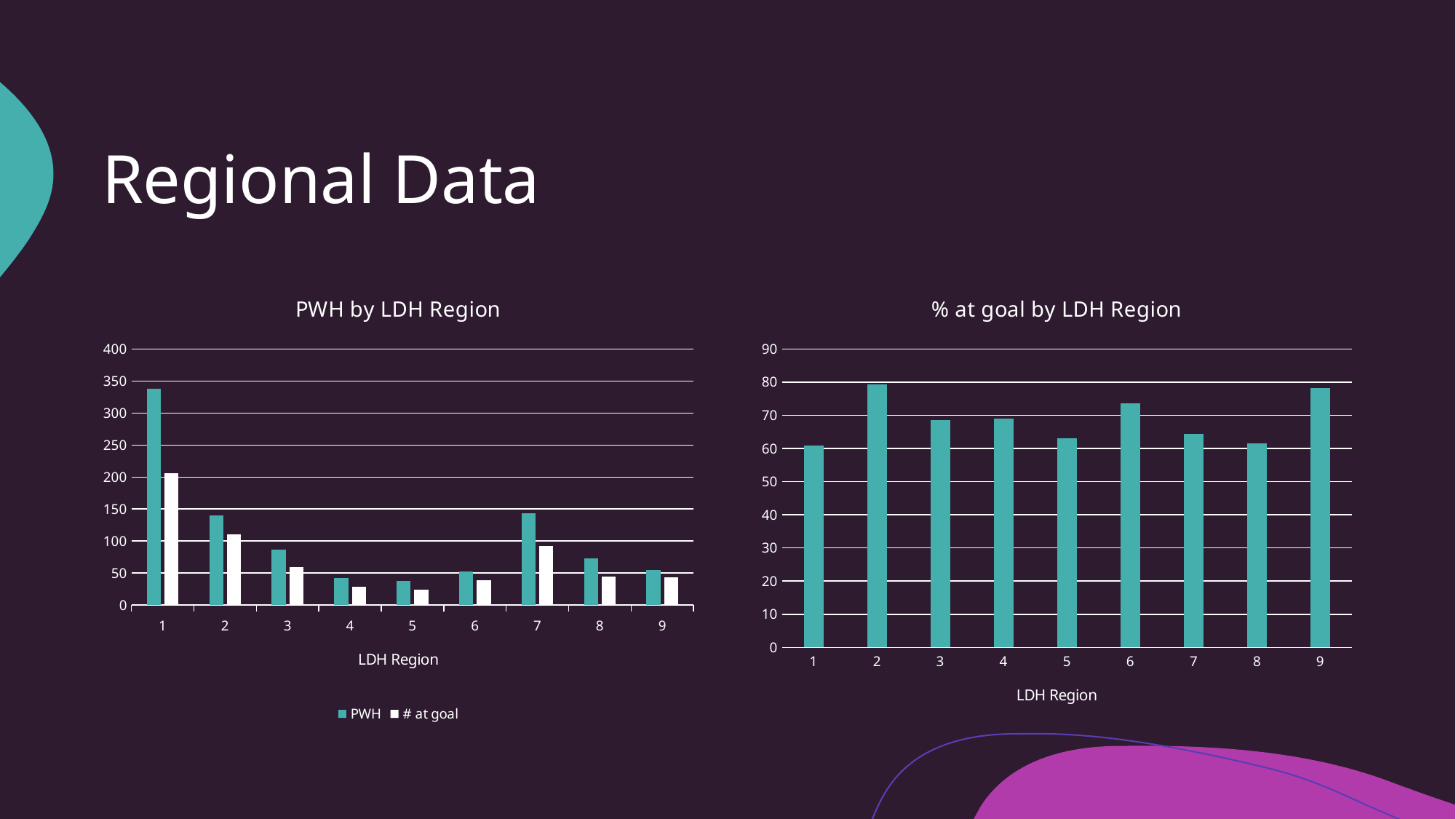
How many LDH regions are shown on the x axis of the "% at goal by LDH Region" chart? 9 How many series does the legend of the "PWH by LDH Region" chart list? 2 In the "% at goal by LDH Region" chart, is the value for region 1 greater or less than 70? less In the "PWH by LDH Region" chart, which region has a larger PWH value: region 7 or region 8? 7 What kind of chart is the "PWH by LDH Region" chart? bar chart In the "PWH by LDH Region" chart, which is larger for region 2: PWH or # at goal? PWH In the "PWH by LDH Region" chart, is the PWH value for region 3 greater or less than 100? less In the "% at goal by LDH Region" chart, is the value for region 2 greater or less than 70? greater In the "PWH by LDH Region" chart, which region has the highest PWH value? 1 What is the x-axis title of the "% at goal by LDH Region" chart? LDH Region